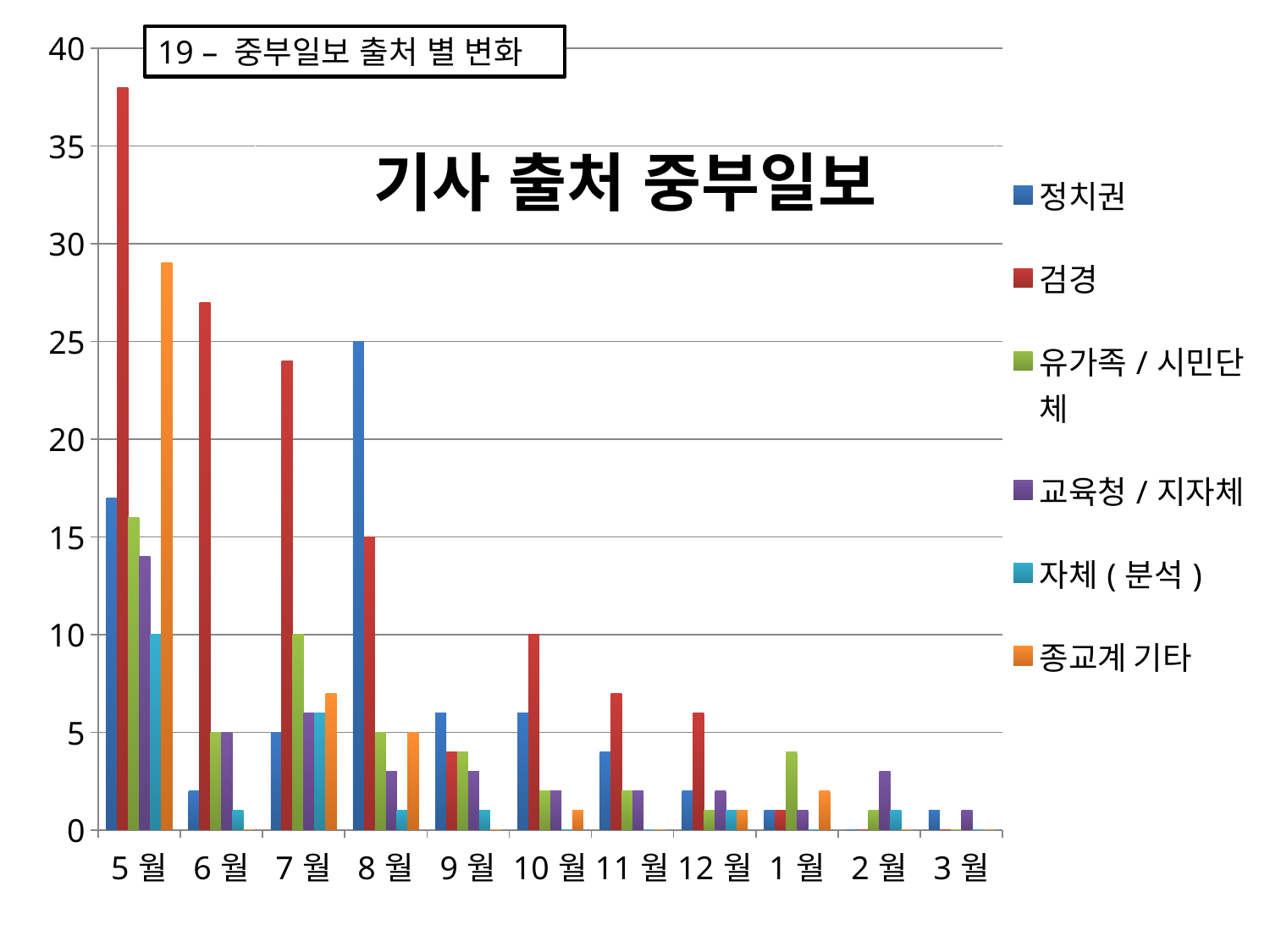
How many month categories are shown on the x axis? 11 What is the value for 검경 in 10 월? 10 How many series does the legend list? 6 Is the value for 검경 in 5 월 greater or less than 35? greater What is the title shown in large text on the chart? 기사 출처 중부일보 Which series has the tallest bar in 5 월? 검경 Is the value for 종교계 기타 in 5 월 greater or less than 25? greater Which is larger in 6 월, 정치권 or 검경? 검경 What is the value for 정치권 in 8 월? 25 Does the value for 검경 rise or fall from 5 월 to 12 월? fall What kind of chart is shown on the slide? bar chart What is the value for 검경 in 8 월? 15